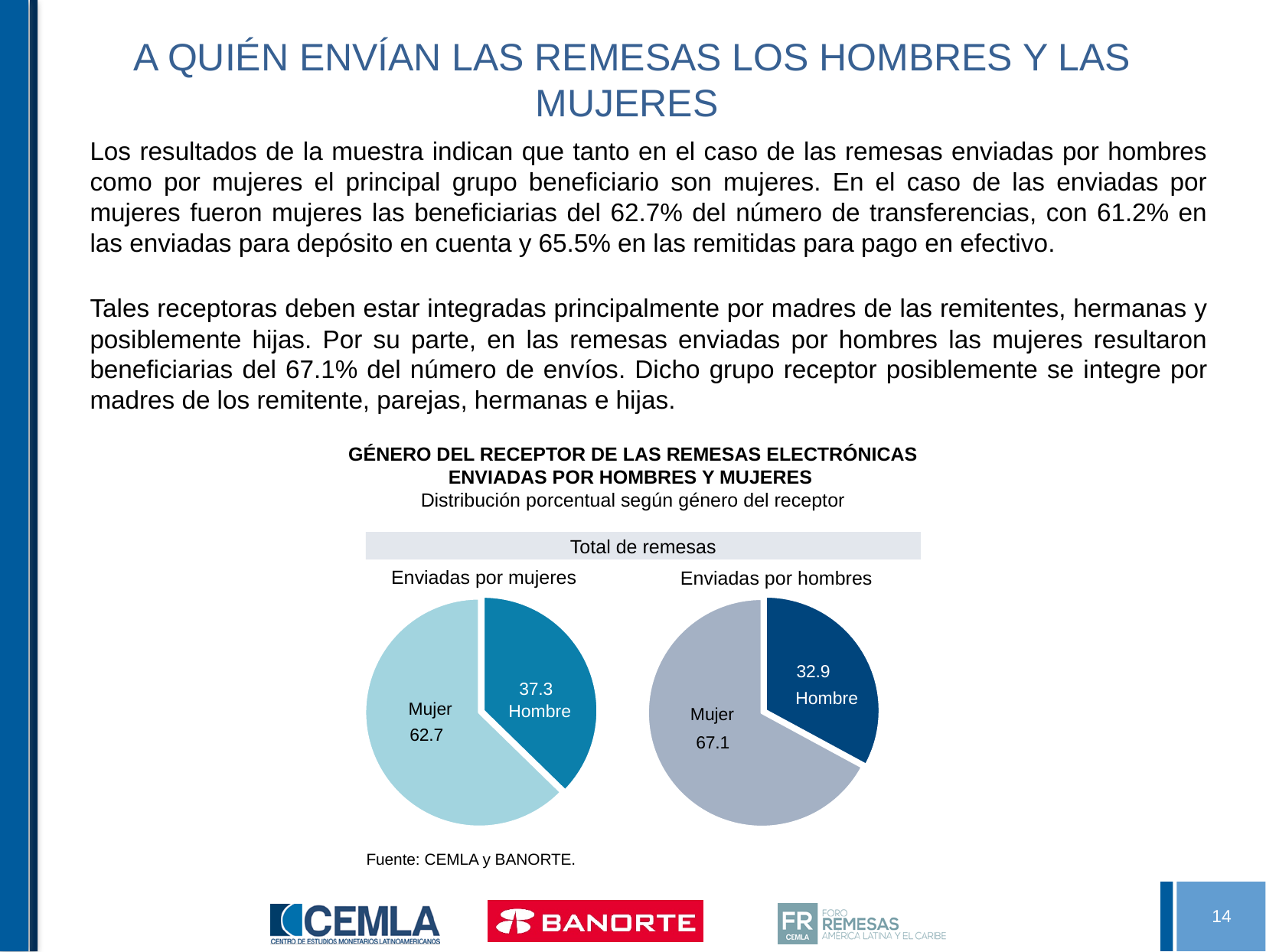
In the 'Enviadas por hombres' pie chart, what is the difference between the Mujer and Hombre values? 34.2 In the 'Enviadas por mujeres' pie chart, what is the value for Mujer? 62.7 Which is larger: the Mujer value in the 'Enviadas por mujeres' chart or the Mujer value in the 'Enviadas por hombres' chart? Enviadas por hombres In the 'Enviadas por hombres' pie chart, what is the value for Mujer? 67.1 What is the title printed above the two pie charts, in the shaded band? Total de remesas In the 'Enviadas por hombres' pie chart, which slice is the largest? Mujer How many slices does the 'Enviadas por hombres' pie chart have? 2 What type of chart is used to show 'Enviadas por mujeres'? Pie chart In the 'Enviadas por mujeres' pie chart, what is the difference between the Mujer and Hombre values? 25.4 In the 'Enviadas por mujeres' pie chart, which slice is the smallest? Hombre In the 'Enviadas por mujeres' pie chart, what is the value for Hombre? 37.3 In the 'Enviadas por hombres' pie chart, what is the value for Hombre? 32.9